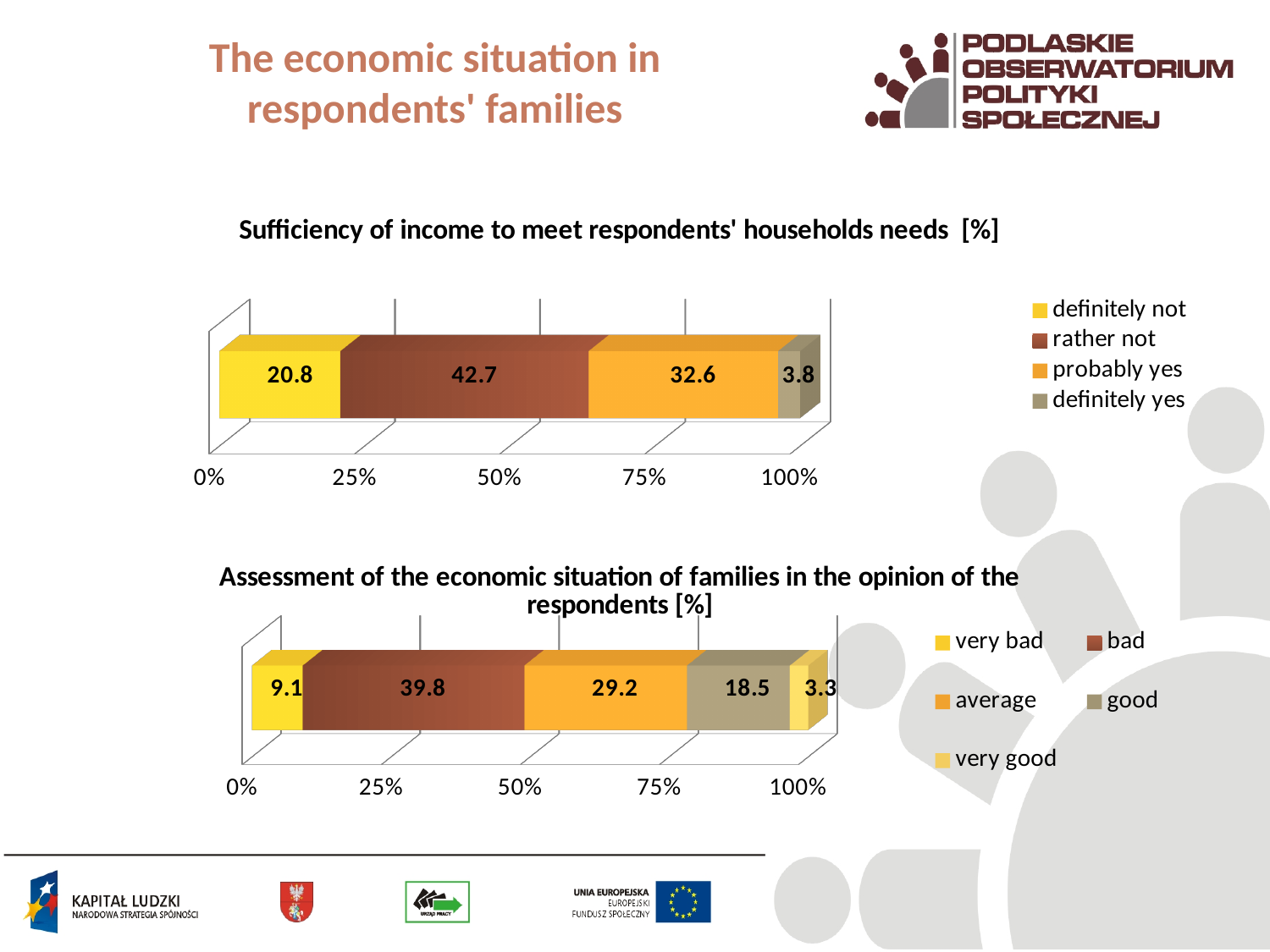
In the 'Assessment of the economic situation of families' chart, which series has the highest value? bad In the 'Assessment of the economic situation of families' chart, what is the value for 'average'? 29.2 In the 'Sufficiency of income to meet respondents' households needs' chart, which series has the lowest value? definitely yes In the 'Assessment of the economic situation of families' chart, how many series does the legend list? 5 In the 'Sufficiency of income to meet respondents' households needs' chart, how many series does the legend list? 4 In the 'Sufficiency of income to meet respondents' households needs' chart, which series has the highest value? rather not In the 'Assessment of the economic situation of families' chart, which is larger, 'very bad' or 'good'? good In the 'Sufficiency of income to meet respondents' households needs' chart, what is the value for 'rather not'? 42.7 What kind of chart is the 'Assessment of the economic situation of families' chart? stacked bar chart In the 'Sufficiency of income to meet respondents' households needs' chart, what is the value for 'definitely yes'? 3.8 In the 'Sufficiency of income to meet respondents' households needs' chart, what is the difference between 'rather not' and 'probably yes'? 10.1 In the 'Assessment of the economic situation of families' chart, what is the value for 'good'? 18.5